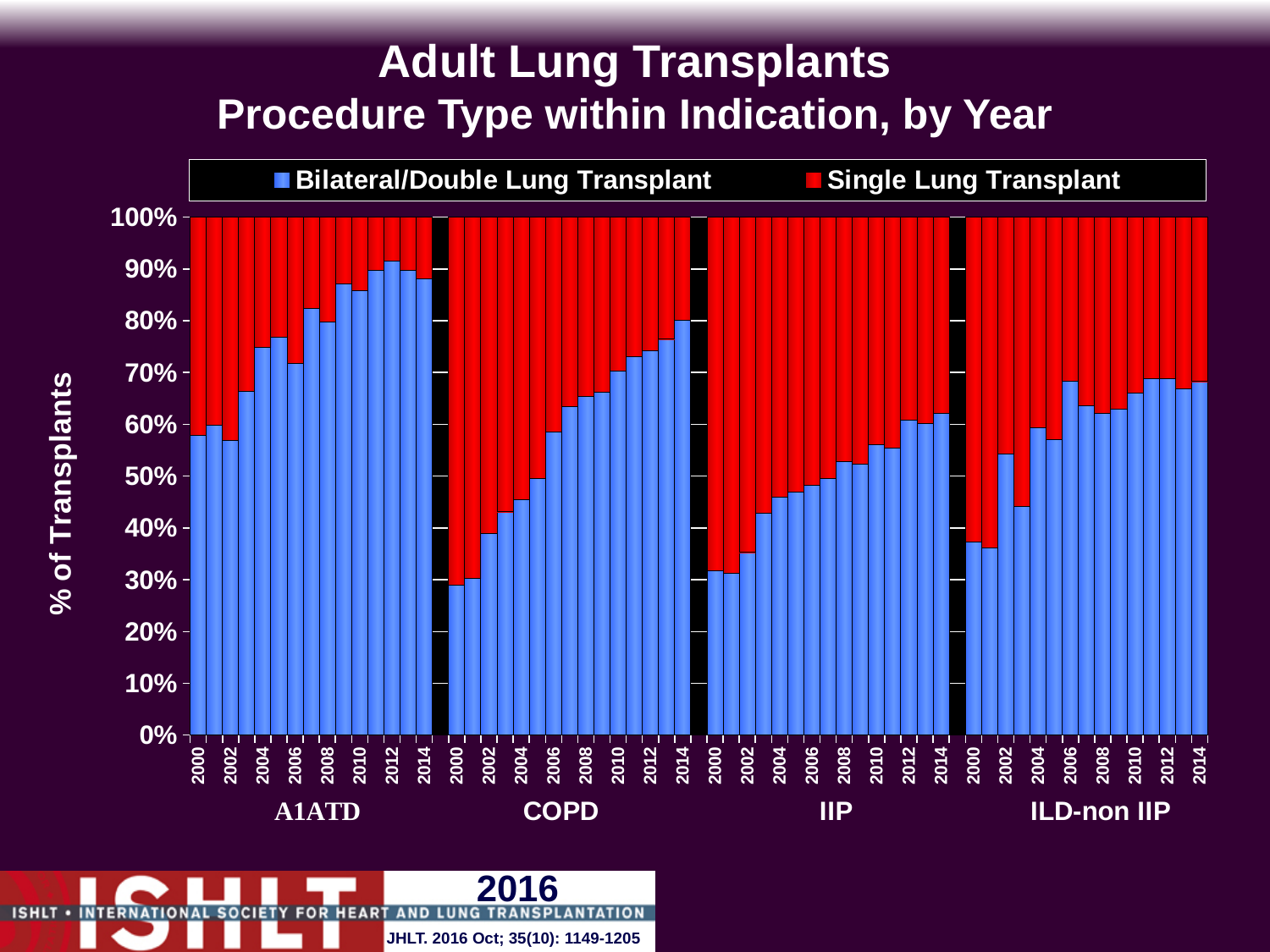
Within the COPD group, does the Bilateral/Double Lung Transplant share rise or fall from 2000 to 2014? rise Within the COPD group, which year has the highest Bilateral/Double Lung Transplant share? 2014 Is the Bilateral/Double Lung Transplant share for IIP in 2000 greater or less than 40%? less Is the Bilateral/Double Lung Transplant share for ILD-non IIP in 2003 greater or less than 50%? less How many series does the legend list? 2 Which series is shown in red in the legend? Single Lung Transplant What kind of chart is shown on the slide? Stacked bar chart What is the label of the y axis? % of Transplants How many indication groups are shown along the x axis? 4 Is the Bilateral/Double Lung Transplant share for COPD in 2000 greater or less than 40%? less